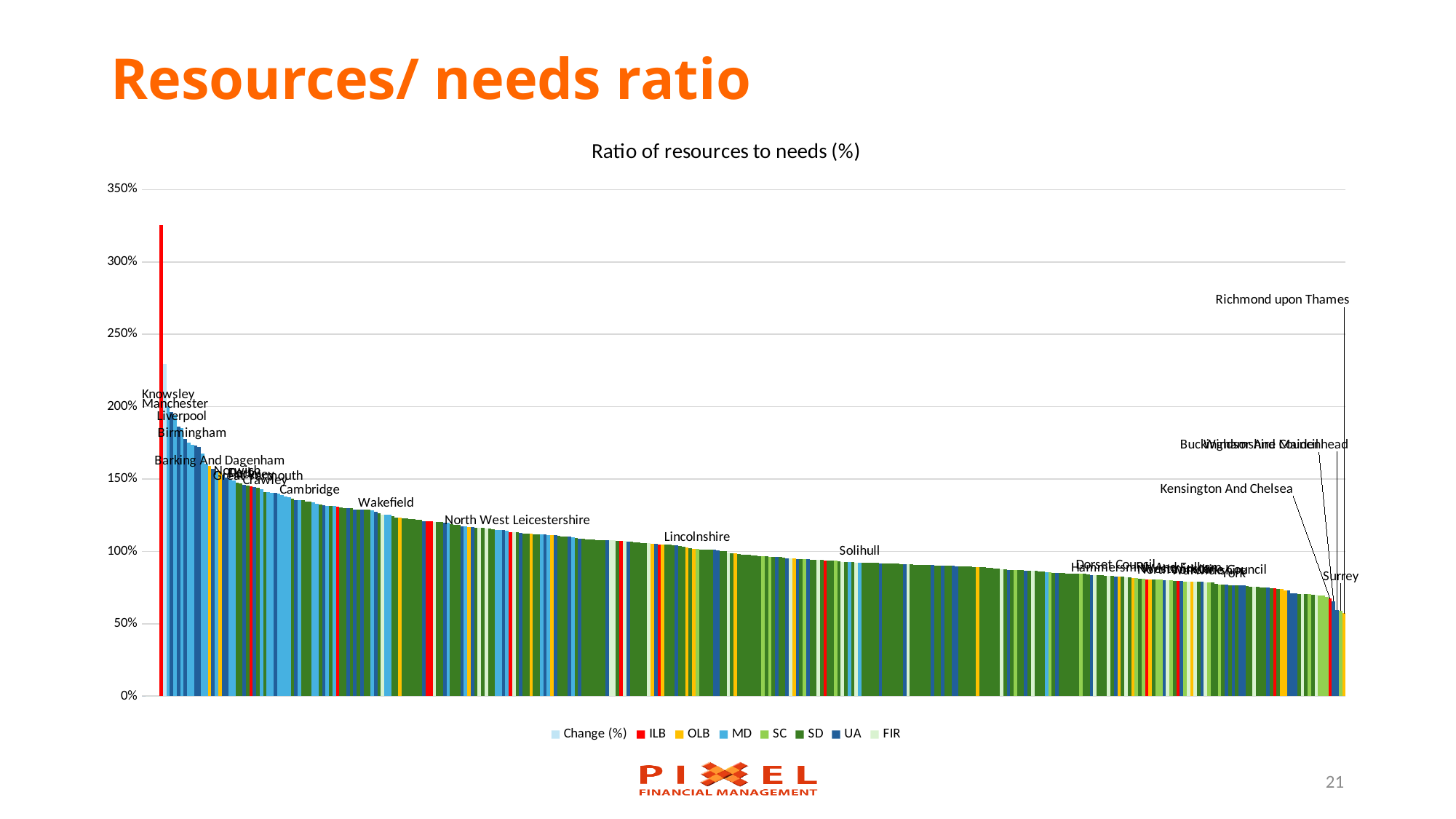
Is the value for Cambridge greater or less than 100%? greater What is the title of the chart? Ratio of resources to needs (%) What kind of chart is shown on the slide? bar chart Which legend entry is shown in red? ILB Is the value for Solihull greater or less than 100%? less Do the bar values generally rise or fall from left to right along the x axis? fall Is the value for Surrey greater or less than 100%? less How many series does the chart legend list? 8 Which of Wakefield and Solihull has the larger value? Wakefield